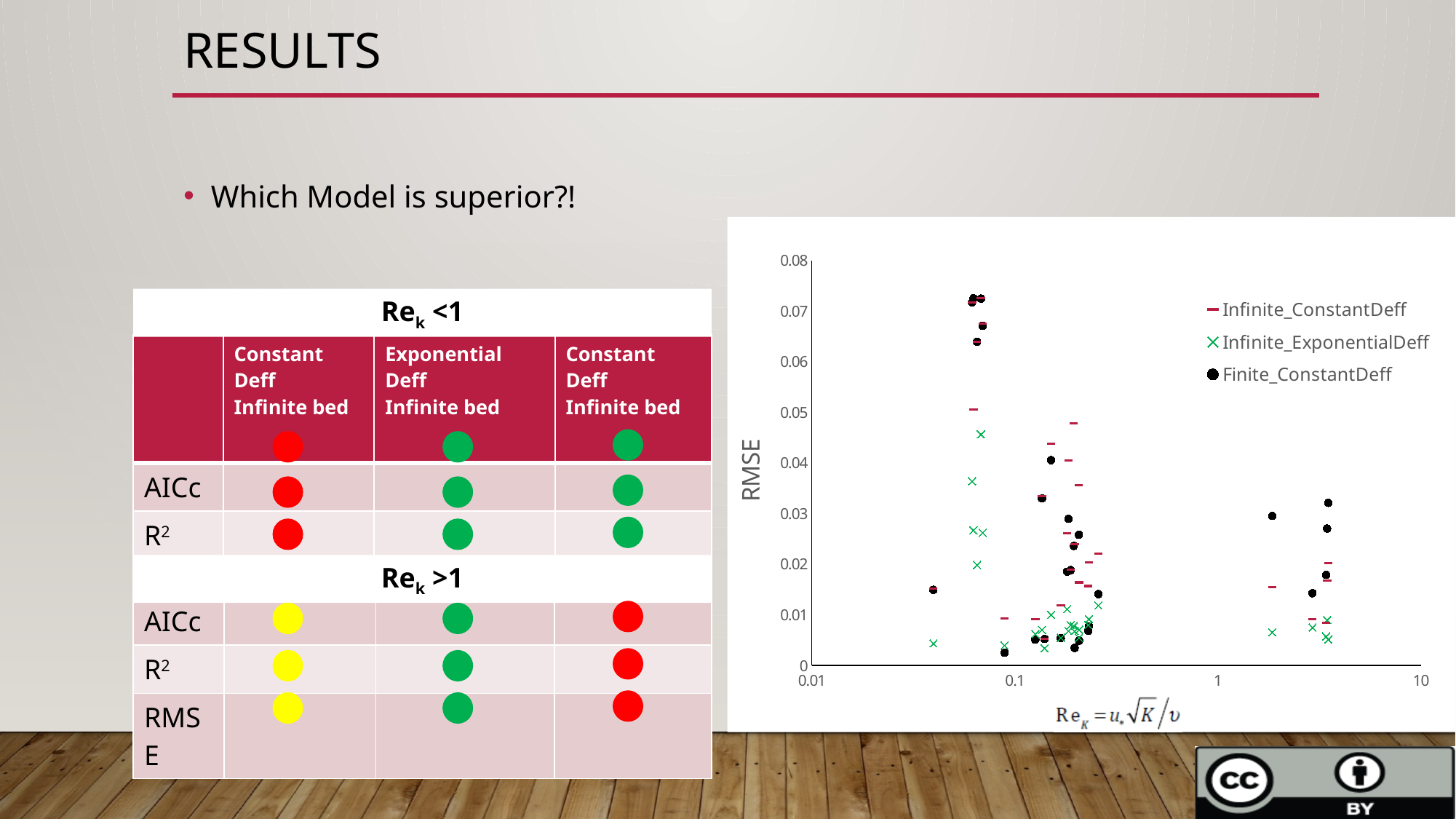
Are the RMSE values plotted for the points near Re_K = 1 to 10 greater or less than 0.04? less What is the lowest value shown on the horizontal axis of the scatter chart? 0.01 How many series does the legend of the scatter chart list? 3 Is the highest RMSE value plotted in the scatter chart greater or less than 0.07? greater Which series in the scatter chart is drawn with black filled circles? Finite_ConstantDeff What kind of chart is shown on the right of the slide? scatter chart What is the highest value shown on the horizontal axis of the scatter chart? 10 Which series in the scatter chart is drawn with green x markers? Infinite_ExponentialDeff What is the highest value shown on the vertical axis of the scatter chart? 0.08 What is the label of the vertical axis of the scatter chart? RMSE